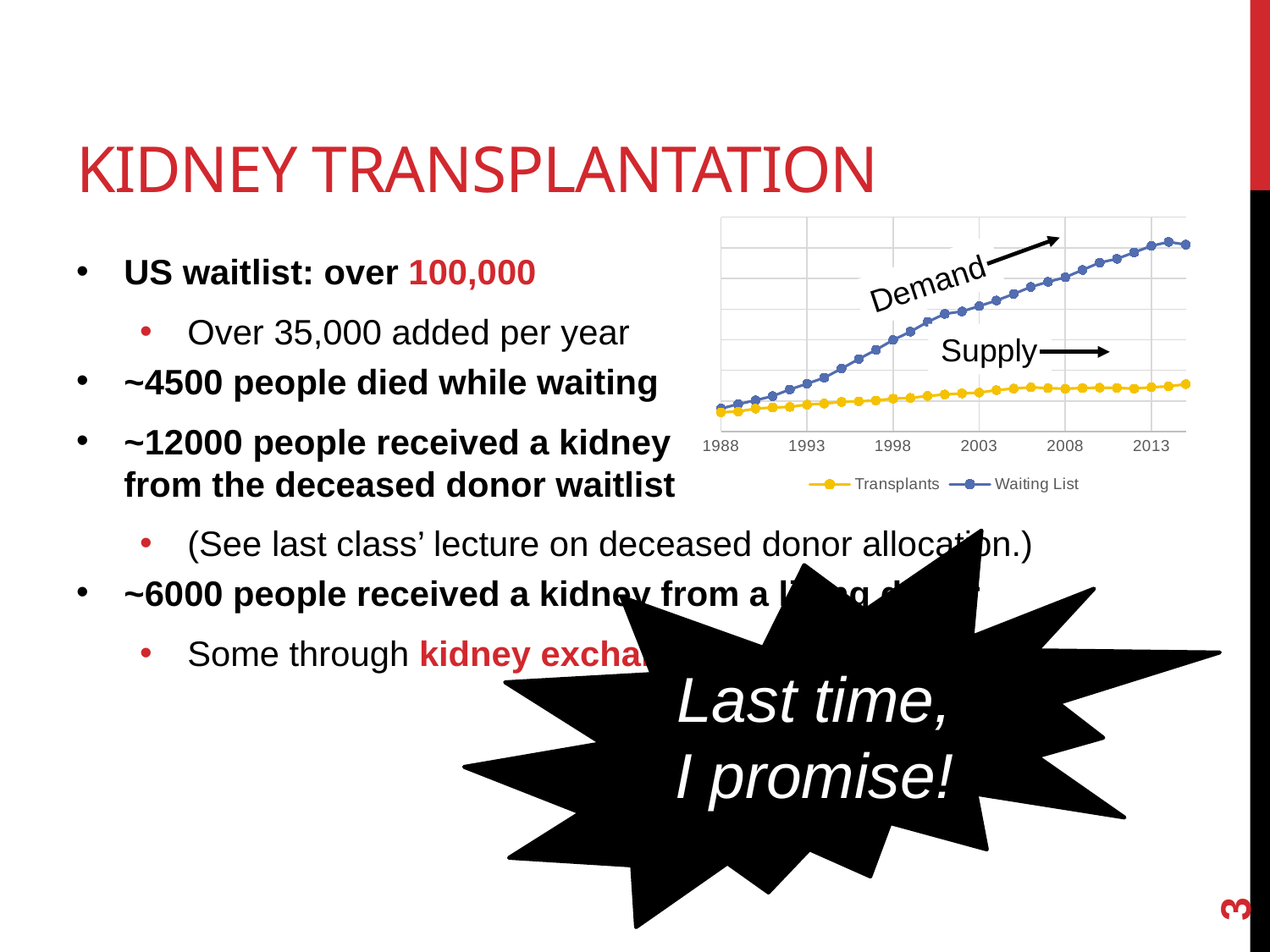
Which series is higher in 2013, Transplants or Waiting List? Waiting List Which series is labelled 'Demand' on the chart? Waiting List How many series does the chart's legend list? 2 Does the Transplants series rise or fall over the years shown? rise What kind of chart is shown on the slide? line chart What is the first year shown on the chart's x axis? 1988 Does the Waiting List series rise or fall from 1988 to 2013? rise What are the two series named in the chart's legend? Transplants and Waiting List Which series grows more steeply over the period shown, Transplants or Waiting List? Waiting List What is the last year tick label shown on the chart's x axis? 2013 What colour is the Transplants line on the chart? yellow How many year tick labels are shown on the chart's x axis? 6